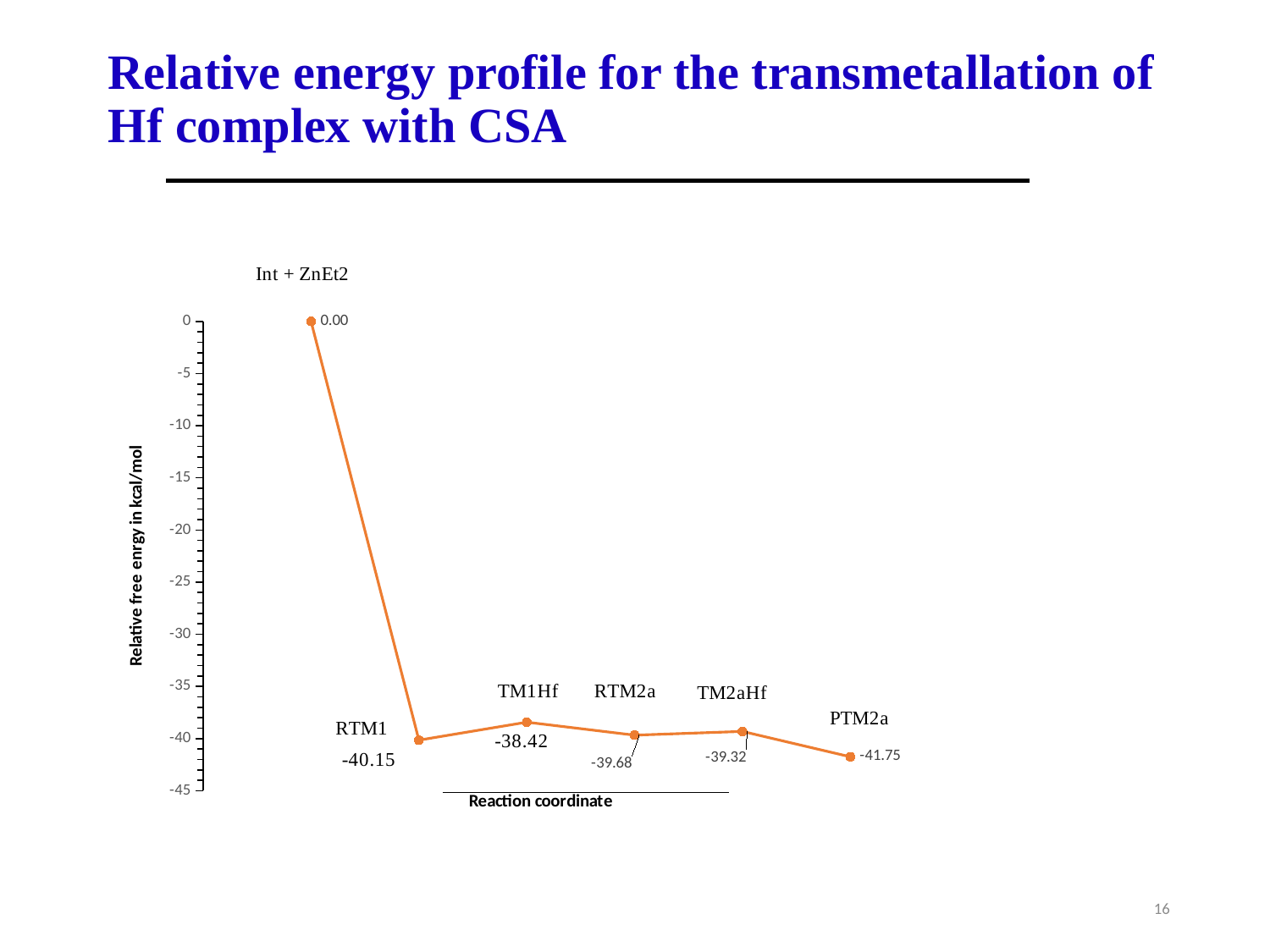
What is the relative free energy value for RTM1? -40.15 Which point on the energy profile has the highest relative free energy? Int + ZnEt2 What is the relative free energy value for TM2aHf? -39.32 What is the label of the vertical axis of the chart? Relative free enrgy in kcal/mol How many points are plotted on the energy profile? 6 What is the relative free energy value for TM1Hf? -38.42 What is the relative free energy value for PTM2a? -41.75 What is the difference in relative free energy between TM1Hf and RTM1? 1.73 Which has a higher relative free energy, TM2aHf or RTM2a? TM2aHf Which point on the energy profile has the lowest relative free energy? PTM2a What is the difference in relative free energy between RTM2a and PTM2a? 2.07 What kind of chart is shown on the slide? Line chart